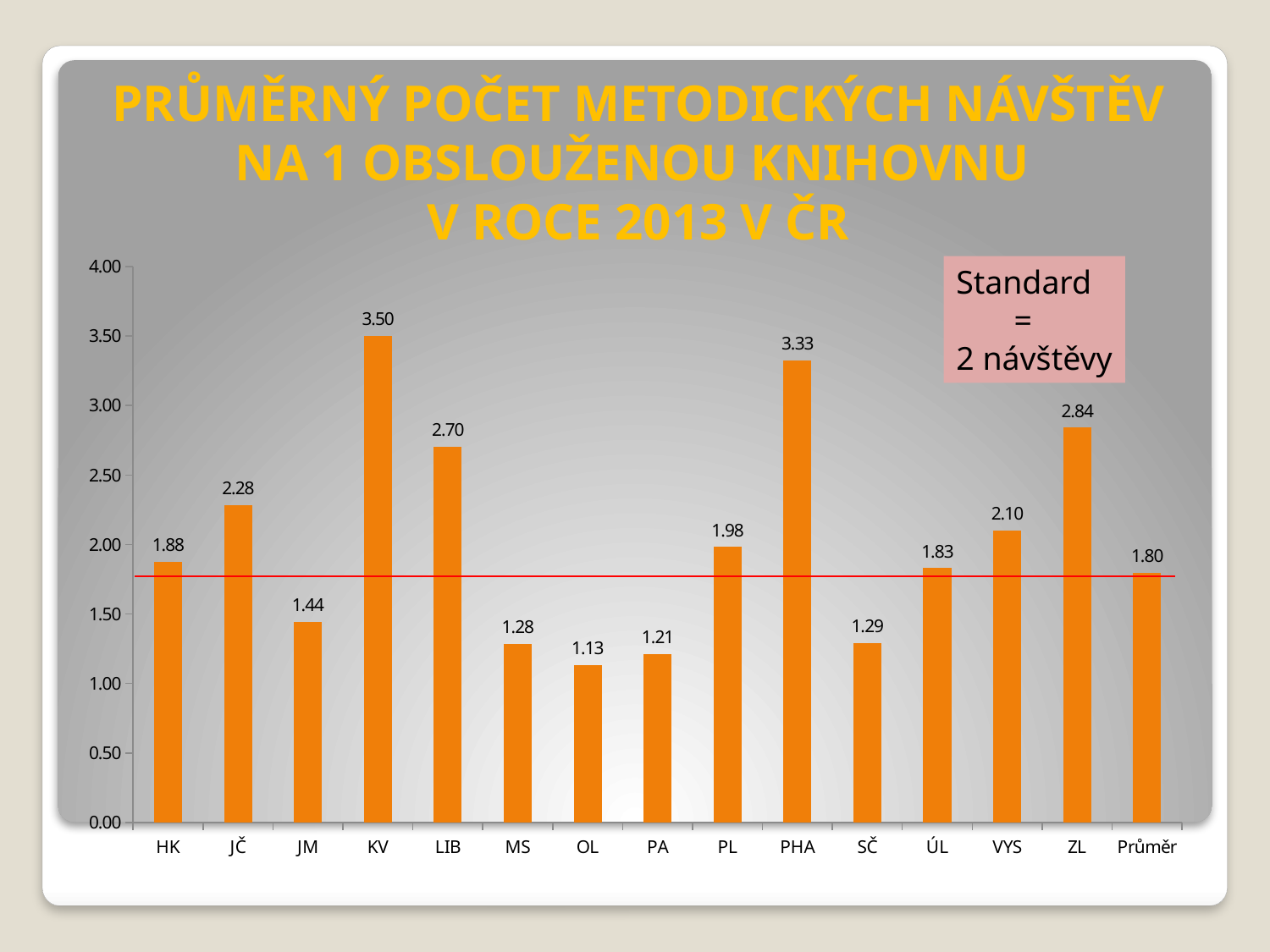
Is the value for JM greater or less than 1.50? less What does the pink box on the chart say the standard is? 2 návštěvy What is the value for Průměr? 1.80 Which category has the lowest value? OL What kind of chart is shown on the slide? bar chart Which category has the highest value? KV What is the difference between the values for ÚL and SČ? 0.54 What is the value for KV? 3.50 What is the value for PHA? 3.33 What is the difference between the values for KV and PHA? 0.17 Which is larger, the value for LIB or the value for ZL? ZL How many categories are shown on the x axis? 15